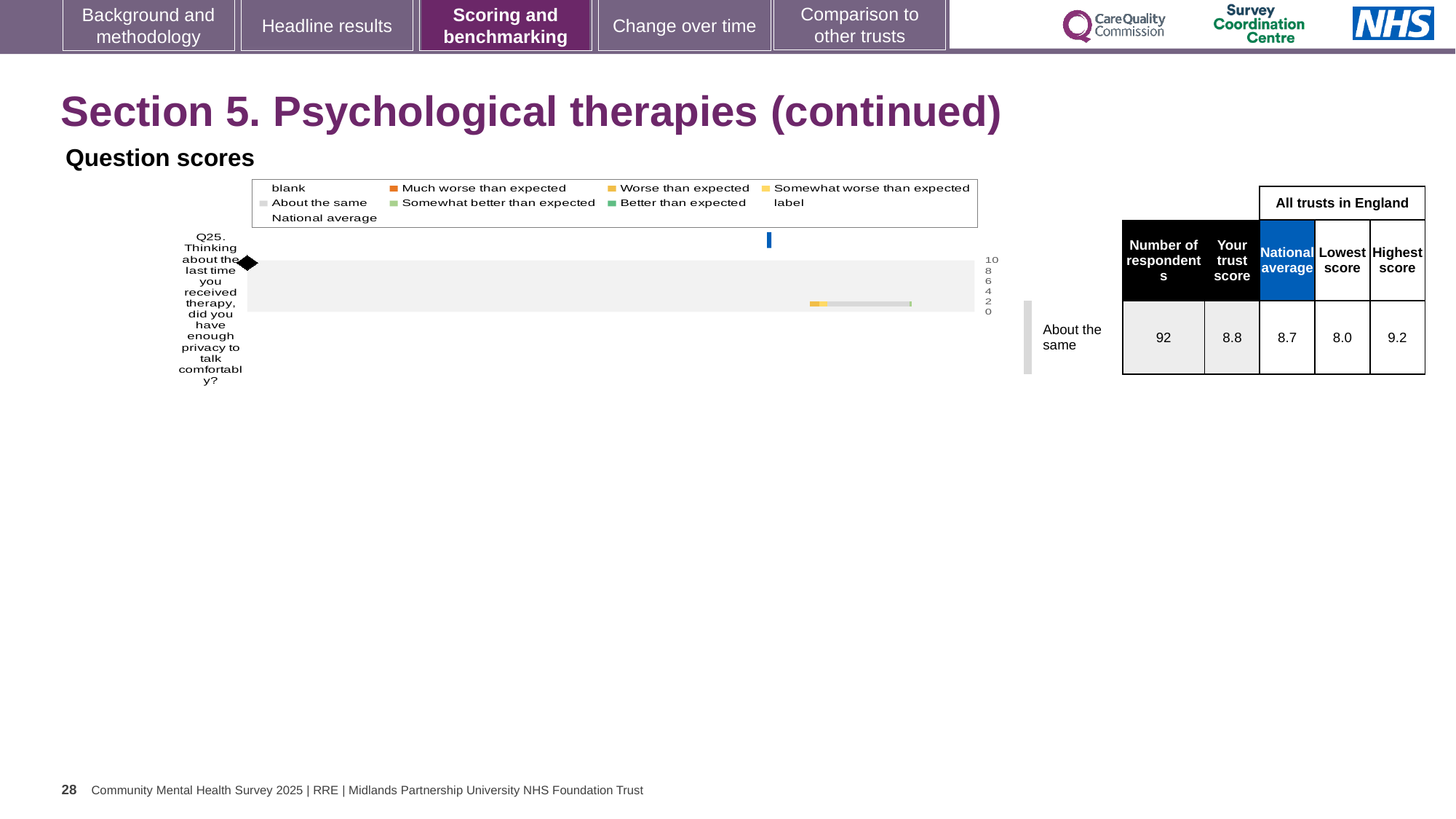
What kind of chart is shown under 'Question scores'? bar chart What is the lowest score among all trusts in England for Q25? 8.0 Which is larger for Q25: the trust's score or the national average? the trust's score What is the highest score among all trusts in England for Q25? 9.2 What is the difference between the highest and lowest scores for Q25 across all trusts in England? 1.2 How many respondents answered Q25? 92 Which benchmark category is the trust's Q25 score placed in? About the same What is the trust's score for Q25 (privacy to talk comfortably during therapy)? 8.8 What is the national average score for Q25? 8.7 How many questions are plotted in the Question scores chart? 1 What colour represents 'Much worse than expected' in the chart legend? orange Which question is plotted in the Question scores chart? Q25